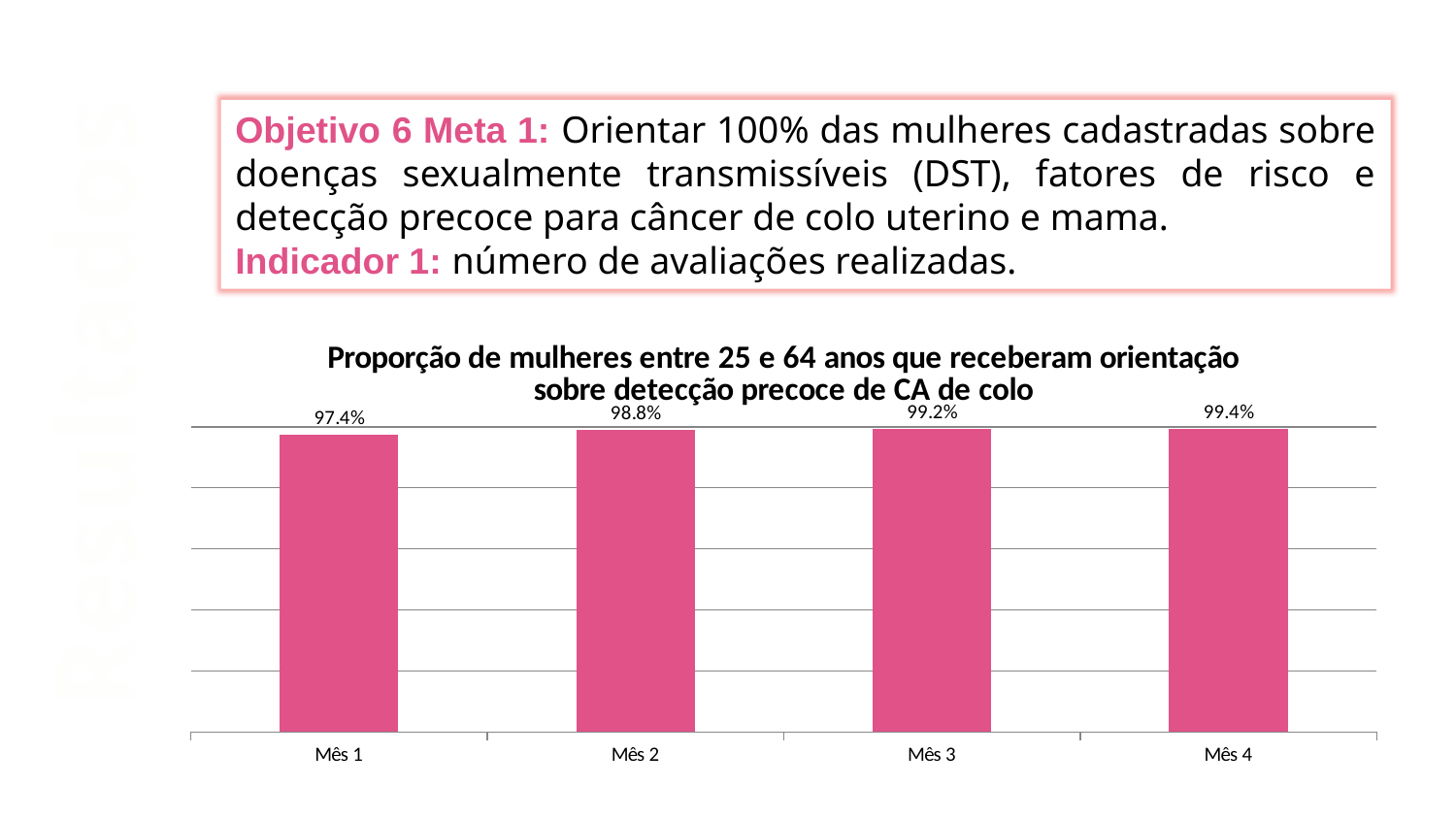
What is the title of the chart? Proporção de mulheres entre 25 e 64 anos que receberam orientação sobre detecção precoce de CA de colo What is the value for Mês 3? 99.2% What is the value for Mês 2? 98.8% What is the value for Mês 4? 99.4% Which month has the highest value? Mês 4 What is the difference between the values for Mês 4 and Mês 1? 2.0 percentage points What is the value for Mês 1? 97.4% Which month has the lowest value? Mês 1 How many months are shown on the x axis? 4 Which is larger, the value for Mês 2 or the value for Mês 3? Mês 3 Do the values rise or fall from Mês 1 to Mês 4? Rise What kind of chart is shown on the slide? Bar chart